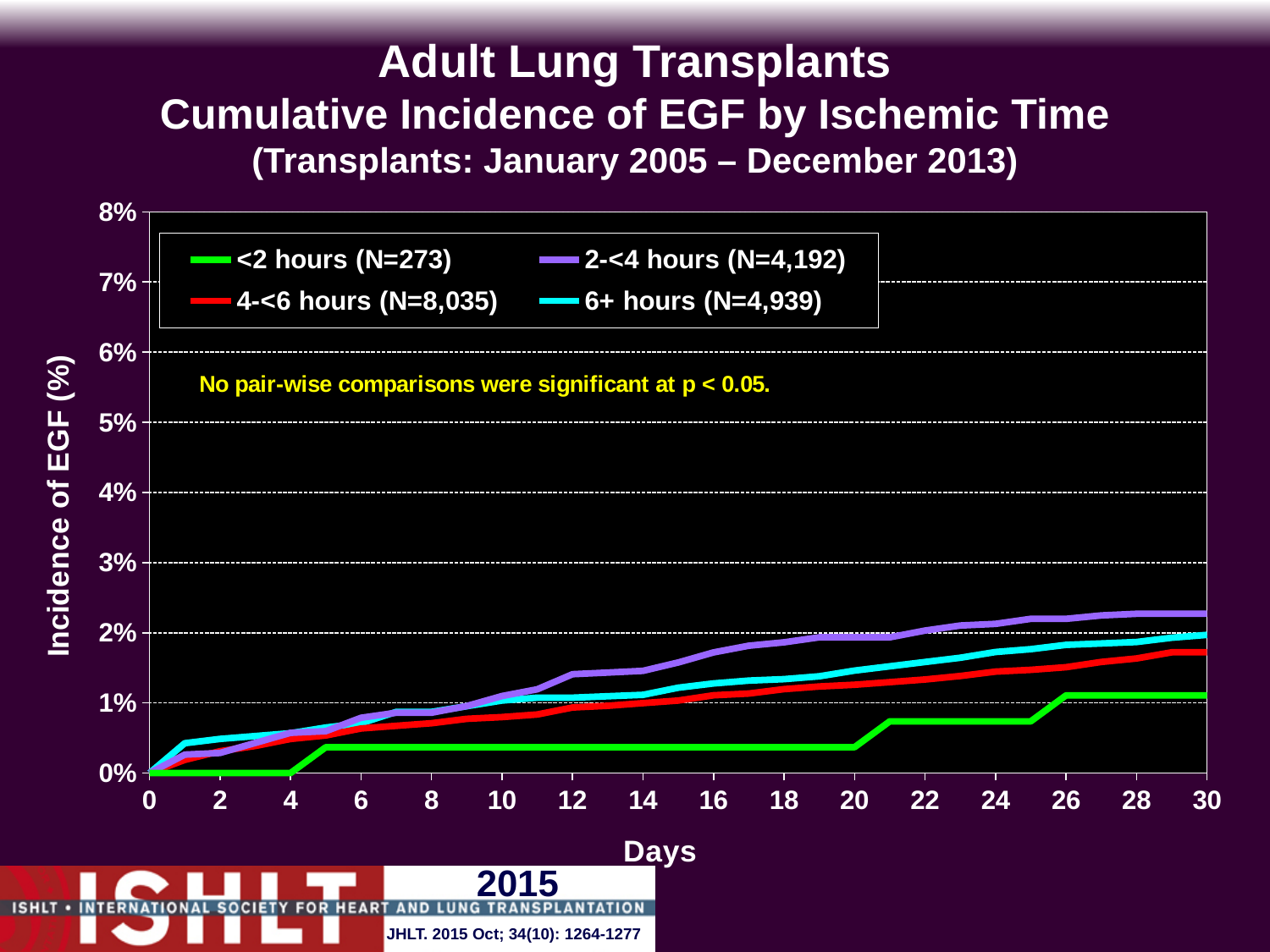
What kind of chart is shown on the slide? line chart At day 30, is the cumulative incidence of EGF for the <2 hours group greater or less than 2%? less What is the N for the 4-<6 hours group shown in the legend? 8,035 At day 30, which group has the higher cumulative incidence of EGF: 2-<4 hours or <2 hours? 2-<4 hours What is the label of the y axis? Incidence of EGF (%) At day 10, is the cumulative incidence of EGF for the <2 hours group greater or less than 1%? less How many series does the legend list? 4 Which ischemic time group has the highest cumulative incidence of EGF at day 30? 2-<4 hours (N=4,192) What is the highest value shown on the y axis? 8% At day 30, is the cumulative incidence of EGF for the 2-<4 hours group greater or less than 2%? greater Which ischemic time group has the lowest cumulative incidence of EGF at day 30? <2 hours (N=273) Do the cumulative incidence lines rise or fall as the number of days increases? rise